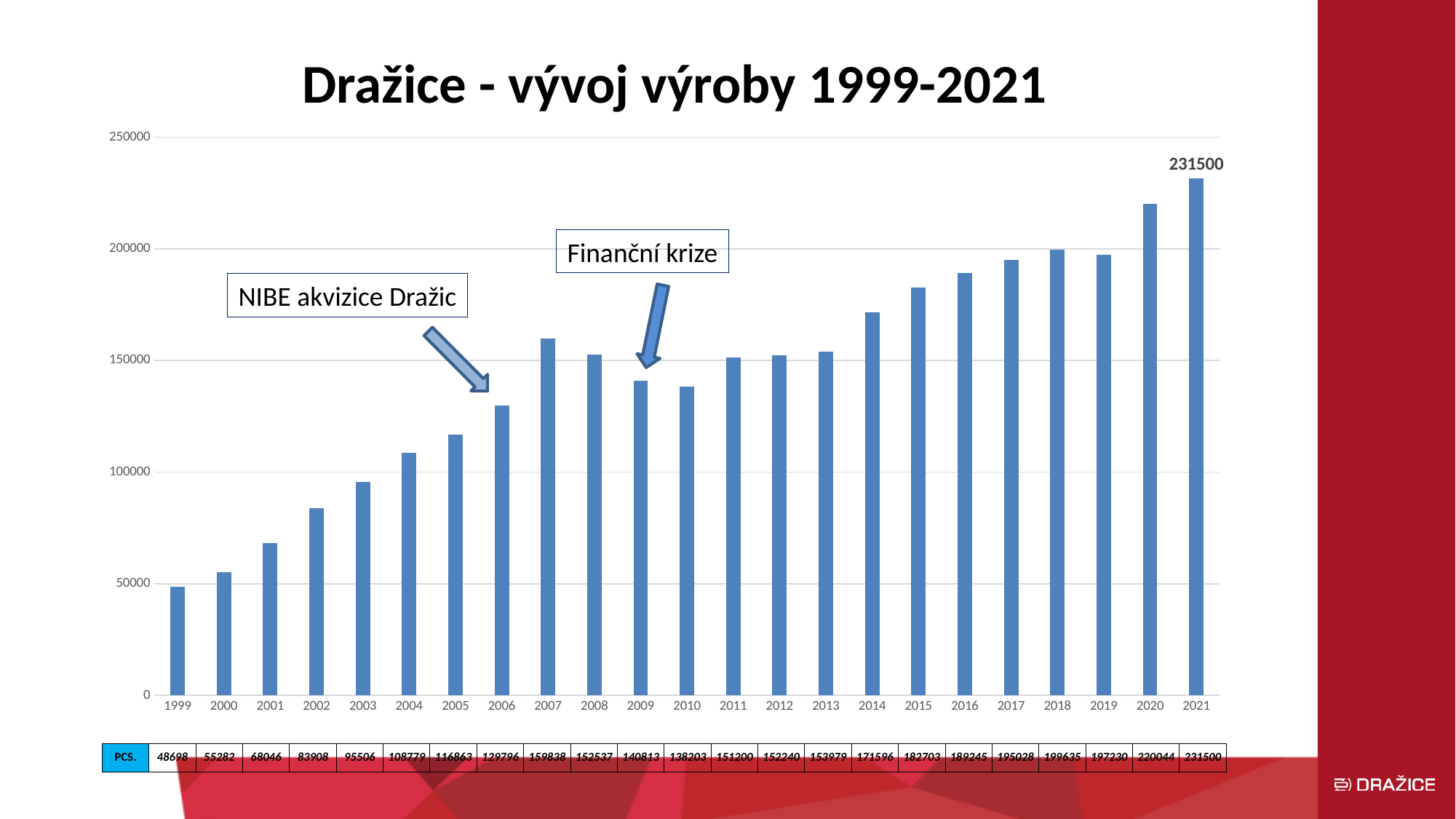
What is the difference between the values for 2021 and 2020? 11456 What is the value for 2007? 159838 Which is larger, the value for 2007 or the value for 2010? 2007 How many years are plotted on the chart? 23 Is the value for 2018 greater or less than 200000? less What is the value for 1999? 48698 Which year has the highest value? 2021 What is the title of the chart? Dražice - vývoj výroby 1999-2021 What is the value for 2021? 231500 Which year has the lowest value? 1999 What type of chart is shown on the slide? bar chart What is the value for 2010? 138203